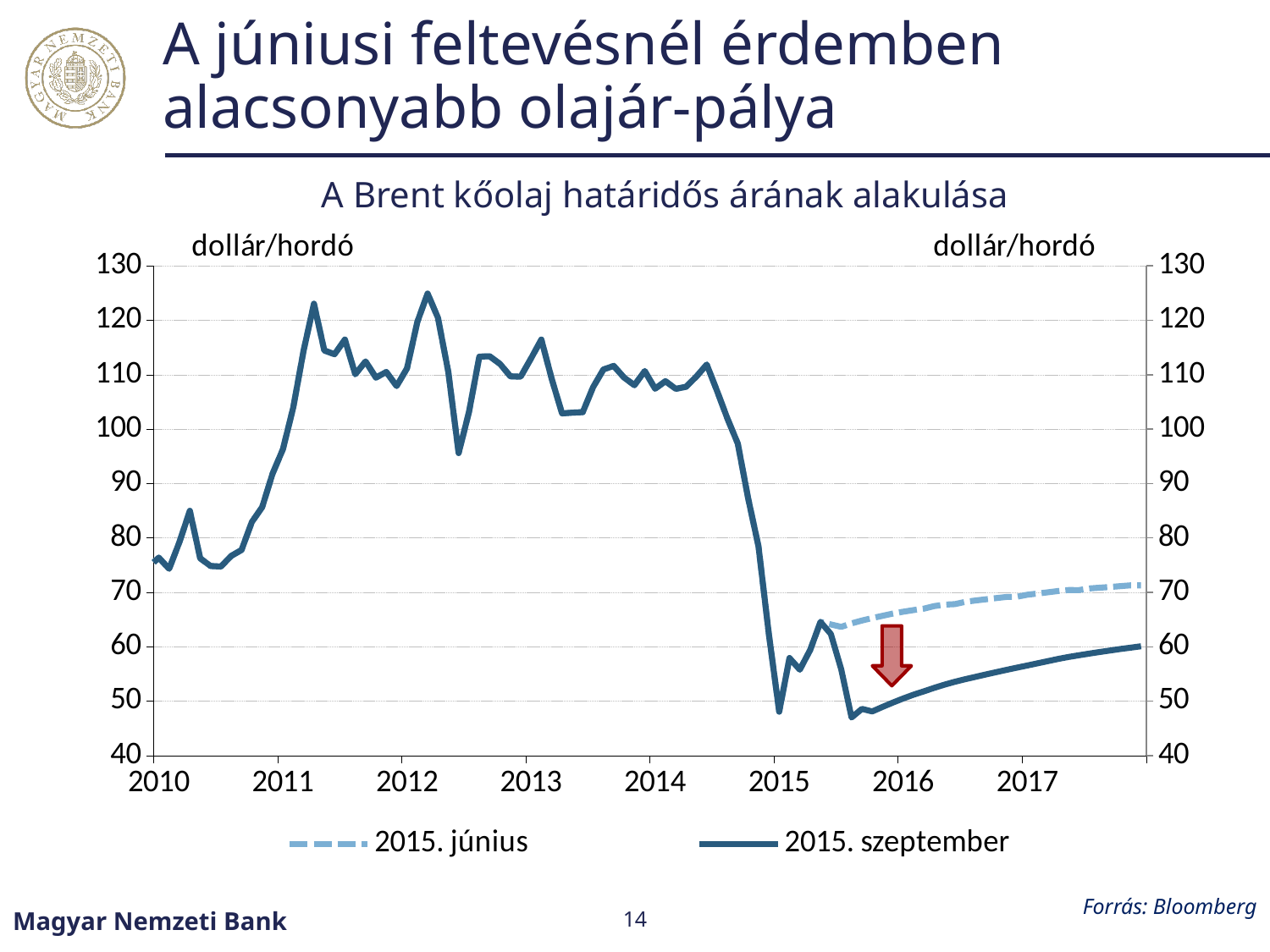
How many series does the legend list? 2 Is the value of the 2015. szeptember series at the end of 2017 greater or less than 50? greater What kind of chart is shown on the slide? line chart What is the title of the chart? A Brent kőolaj határidős árának alakulása Is the value of the 2015. szeptember series at the start of 2010 greater or less than 90? less Does the 2015. szeptember series rise or fall between mid-2014 and the start of 2015? fall Is the value of the 2015. június series at the end of 2017 greater or less than 60? greater At the end of 2017, which series is higher: 2015. június or 2015. szeptember? 2015. június What are the two series named in the legend? 2015. június and 2015. szeptember Does the 2015. szeptember series rise or fall between 2016 and the end of 2017? rise